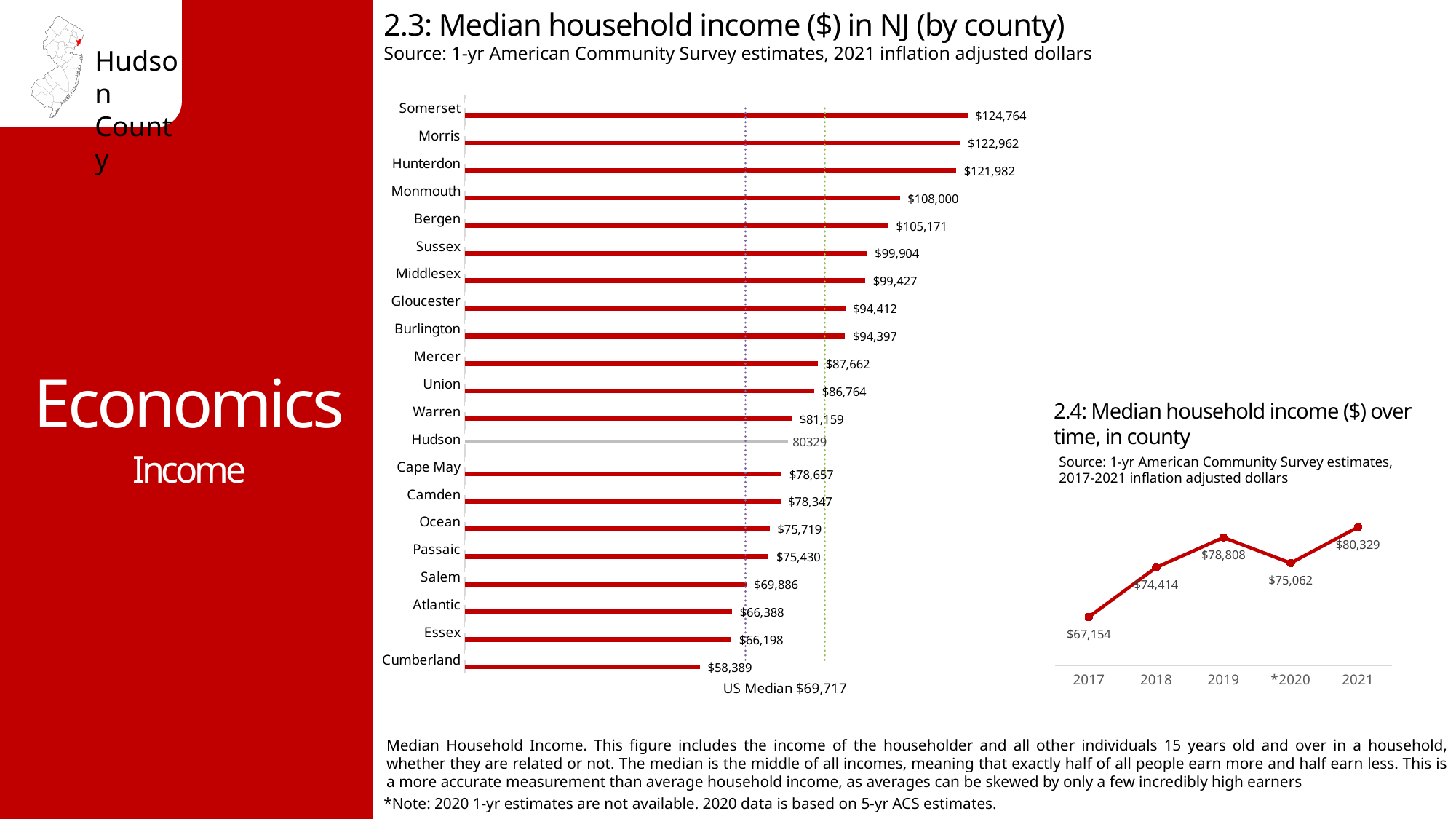
In the chart '2.4: Median household income ($) over time, in county', what is the value for 2019? $78,808 In the chart '2.3: Median household income ($) in NJ (by county)', what is the difference between Somerset and Cumberland? $66,375 In the chart '2.3: Median household income ($) in NJ (by county)', what US Median value is noted below the chart? $69,717 In the chart '2.3: Median household income ($) in NJ (by county)', which is larger, Bergen or Monmouth? Monmouth What kind of chart is '2.3: Median household income ($) in NJ (by county)'? bar chart In the chart '2.3: Median household income ($) in NJ (by county)', which county has the highest median household income? Somerset In the chart '2.3: Median household income ($) in NJ (by county)', what is the value for Somerset? $124,764 In the chart '2.4: Median household income ($) over time, in county', what is the difference between the 2021 and 2017 values? $13,175 In the chart '2.3: Median household income ($) in NJ (by county)', which county has the lowest median household income? Cumberland In the chart '2.3: Median household income ($) in NJ (by county)', what is the value shown for Hudson? 80329 What kind of chart is '2.4: Median household income ($) over time, in county'? line chart How many counties are plotted in the chart '2.3: Median household income ($) in NJ (by county)'? 21